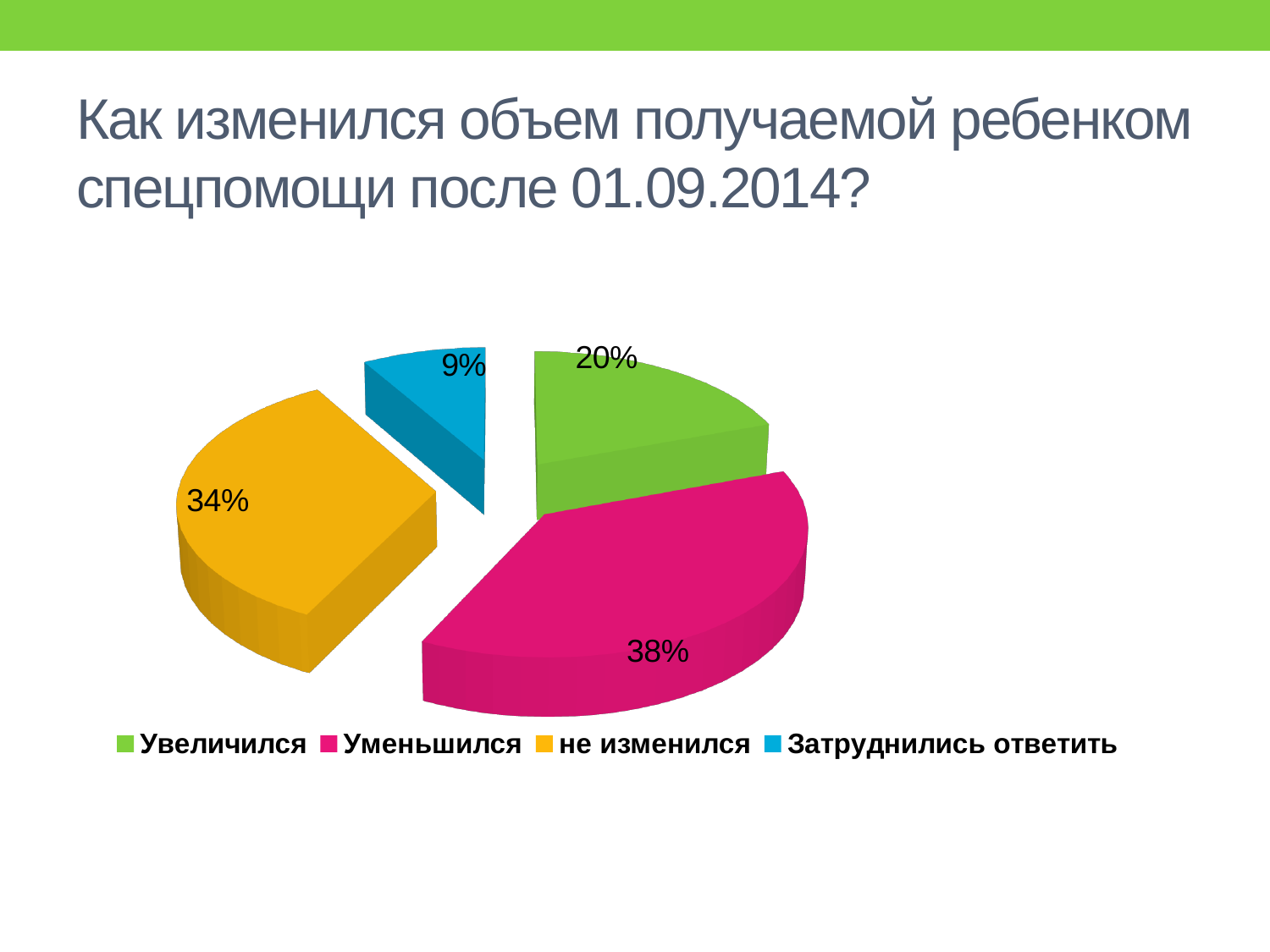
What colour is the slice for "Уменьшился"? pink (magenta) Which category has the smallest slice of the pie? Затруднились ответить What is the difference in percentage points between "Уменьшился" and "Увеличился"? 18 What share of the pie is labelled "Увеличился"? 20% How many entries does the legend list? 4 What share of the pie is labelled "не изменился"? 34% What share of the pie is labelled "Уменьшился"? 38% What share of the pie is labelled "Затруднились ответить"? 9% What kind of chart is shown on the slide? pie chart How many slices does the pie chart have? 4 Which category has the largest slice of the pie? Уменьшился Which is larger, the slice for "не изменился" or the slice for "Увеличился"? не изменился